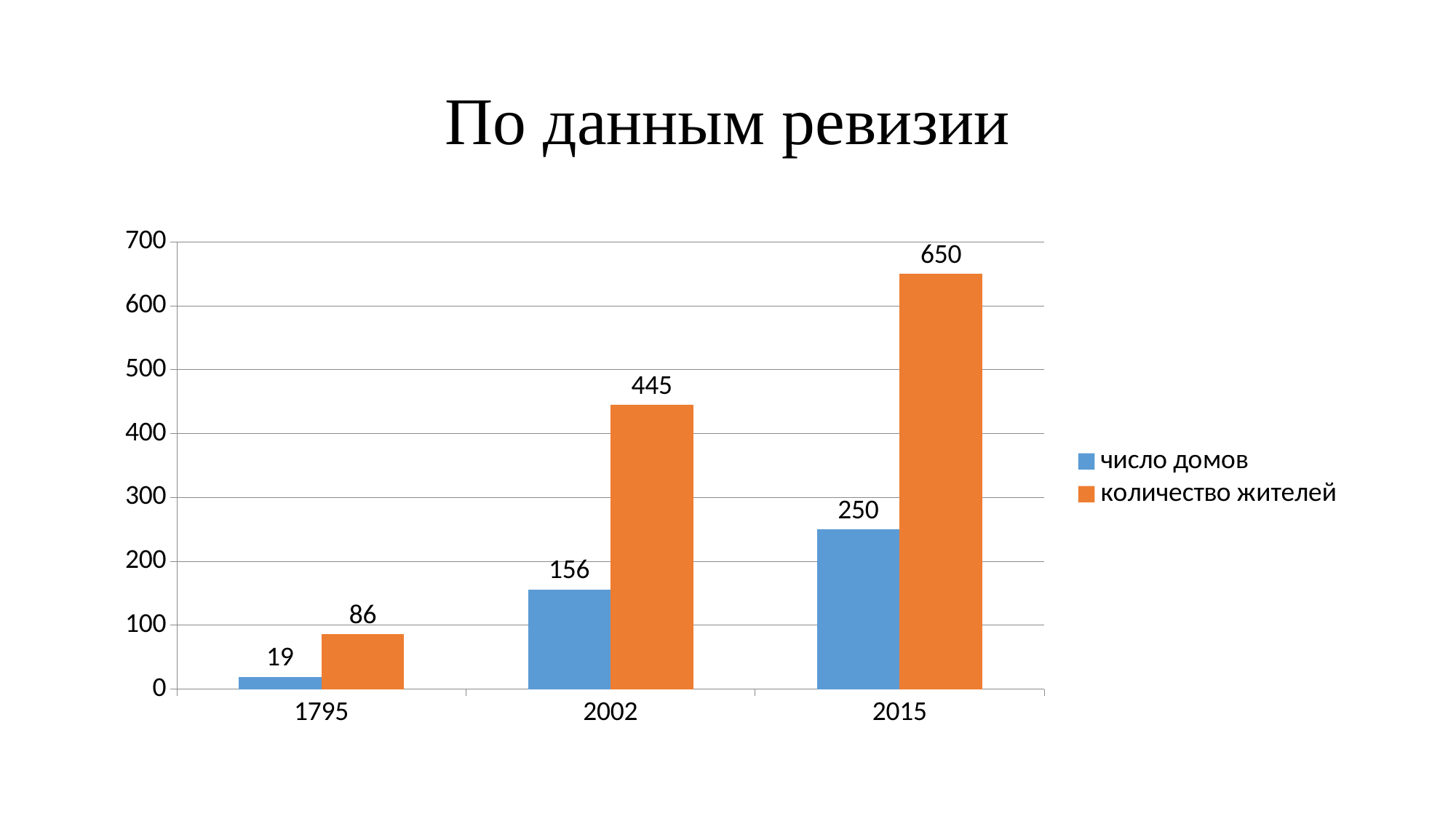
What is the value of число домов for 2015? 250 Which is larger: число домов in 2015 or количество жителей in 2002? количество жителей in 2002 What is the value of число домов for 1795? 19 What kind of chart is shown on the slide? bar chart Which year has the highest value for количество жителей? 2015 What is the difference between количество жителей in 2015 and in 2002? 205 How many series does the legend list? 2 What is the difference between число домов and количество жителей in 1795? 67 What is the value of количество жителей for 2002? 445 Which year has the lowest value for число домов? 1795 How many years are shown on the x axis? 3 Does the value of число домов rise or fall from 1795 to 2015? rise